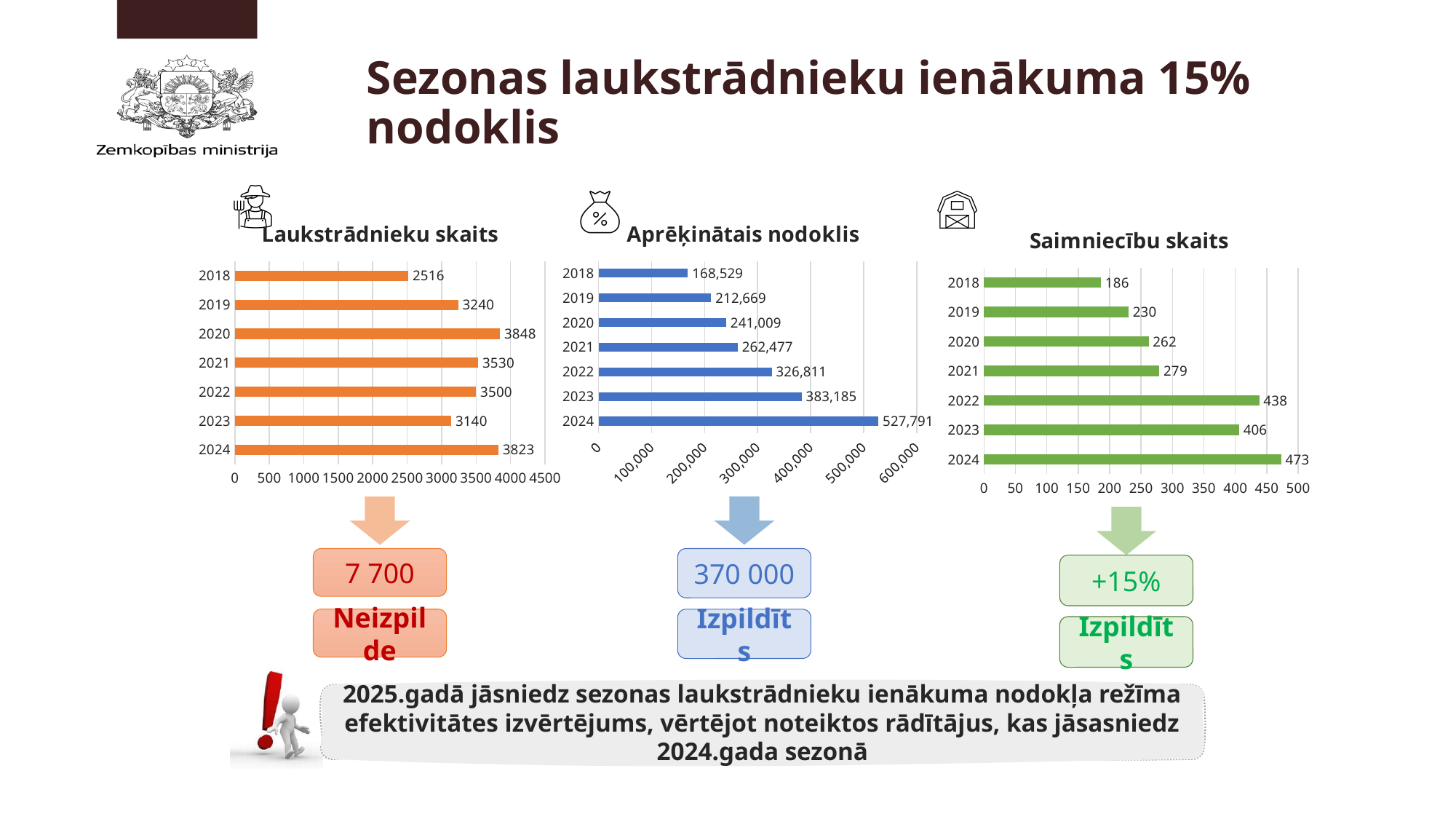
In the "Laukstrādnieku skaits" chart, how many years are shown? 7 In the "Saimniecību skaits" chart, what is the difference between the values for 2024 and 2018? 287 In the "Aprēķinātais nodoklis" chart, what is the value for 2022? 326,811 In the "Aprēķinātais nodoklis" chart, do the values rise or fall from 2018 to 2024? rise What type of chart is the "Saimniecību skaits" chart? bar chart In the "Laukstrādnieku skaits" chart, what is the value for 2020? 3848 In the "Laukstrādnieku skaits" chart, what is the difference between the values for 2024 and 2023? 683 In the "Aprēķinātais nodoklis" chart, which year has the highest value? 2024 In the "Aprēķinātais nodoklis" chart, what is the difference between the values for 2024 and 2023? 144,606 In the "Saimniecību skaits" chart, what is the value for 2021? 279 In the "Saimniecību skaits" chart, which is larger, the value for 2022 or the value for 2023? 2022 In the "Laukstrādnieku skaits" chart, which year has the lowest value? 2018